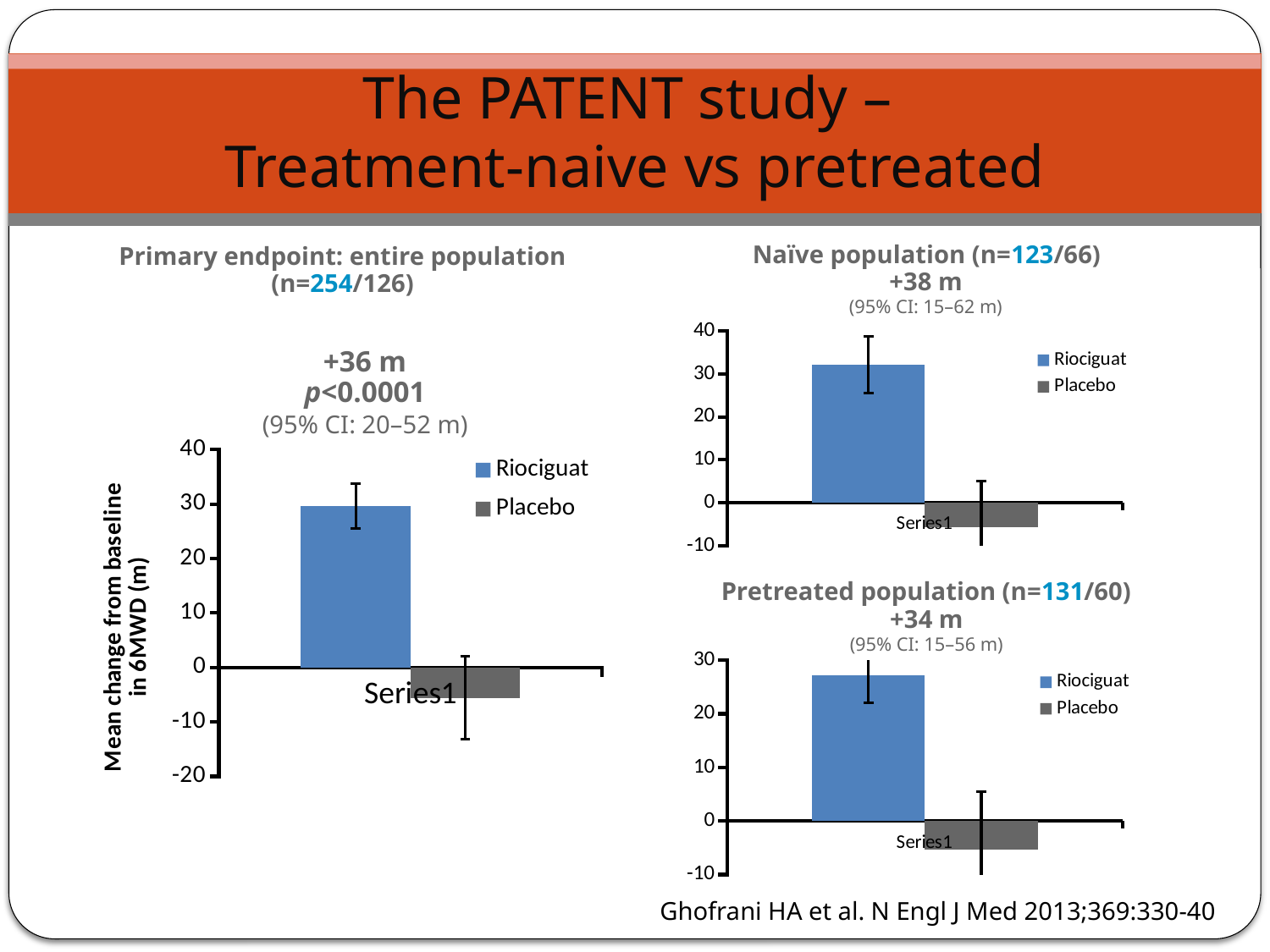
In the 'Naïve population' chart, is the value for Riociguat greater or less than 20? greater How many series does the legend of the 'Naïve population' chart list? 2 In the 'Primary endpoint: entire population' chart, is the value for Riociguat greater or less than 20? greater What are the two legend entries in the 'Pretreated population' chart? Riociguat and Placebo What is the y-axis label of the 'Primary endpoint: entire population' chart? Mean change from baseline in 6MWD (m) In the 'Pretreated population' chart, is the value for Placebo greater or less than 0? less What kind of chart is the 'Primary endpoint: entire population' chart? bar chart In the 'Pretreated population' chart, which series has the higher value, Riociguat or Placebo? Riociguat In the 'Naïve population' chart, which series has the lower value, Riociguat or Placebo? Placebo In the 'Primary endpoint: entire population' chart, which series has the larger value, Riociguat or Placebo? Riociguat